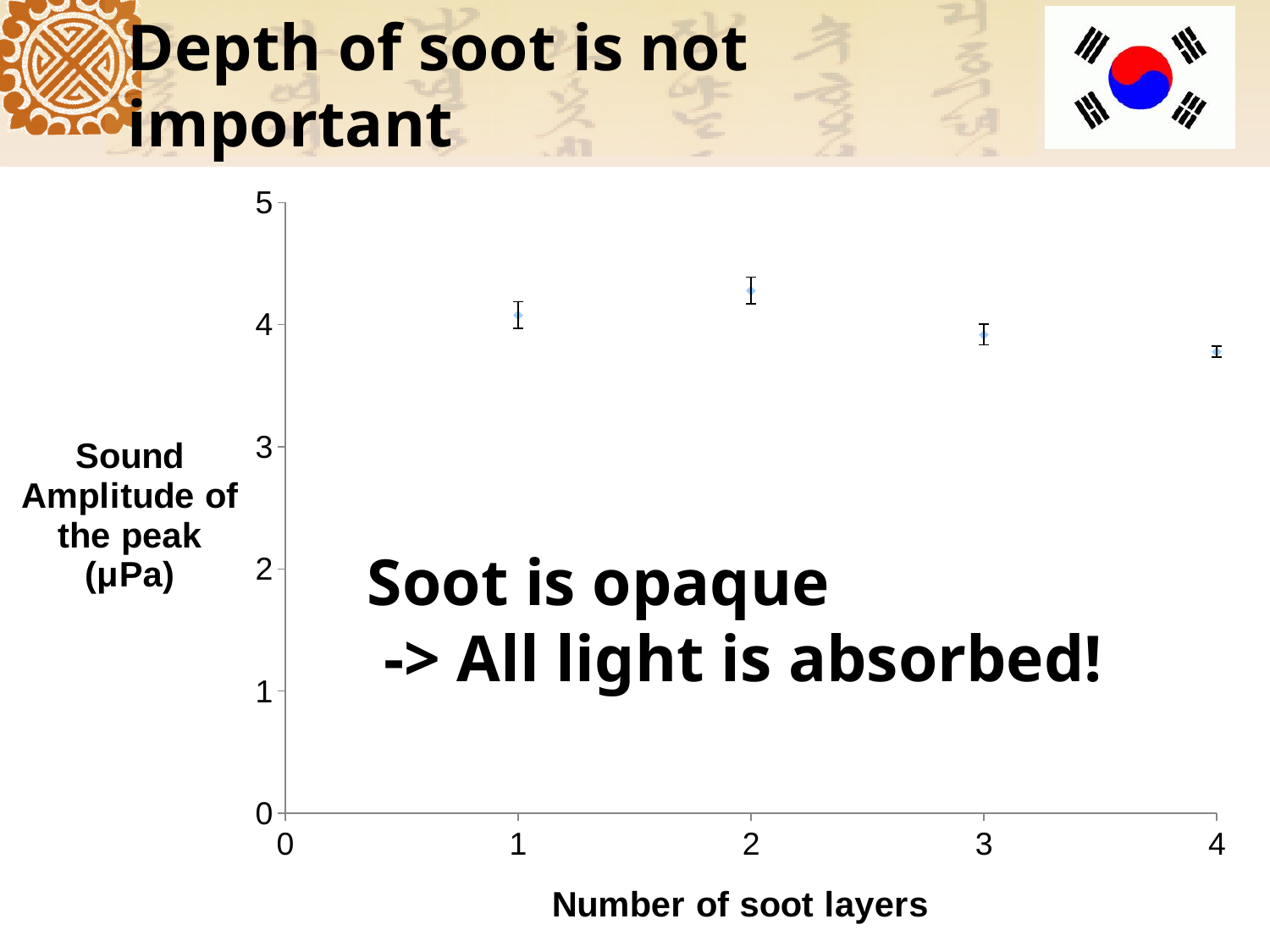
Which number of soot layers has the lowest sound amplitude? 4 Is the sound amplitude for 3 soot layers greater or less than 3? greater What is the label of the y axis? Sound Amplitude of the peak (μPa) Which has a larger sound amplitude: 1 soot layer or 4 soot layers? 1 soot layer Which number of soot layers has the highest sound amplitude? 2 Is the sound amplitude for 1 soot layer greater or less than 5? less What is the label of the x axis? Number of soot layers Is the sound amplitude for 4 soot layers greater or less than 4? less How many data points are plotted on the chart? 4 What kind of chart is shown on the slide? scatter plot Which has a larger sound amplitude: 2 soot layers or 4 soot layers? 2 soot layers